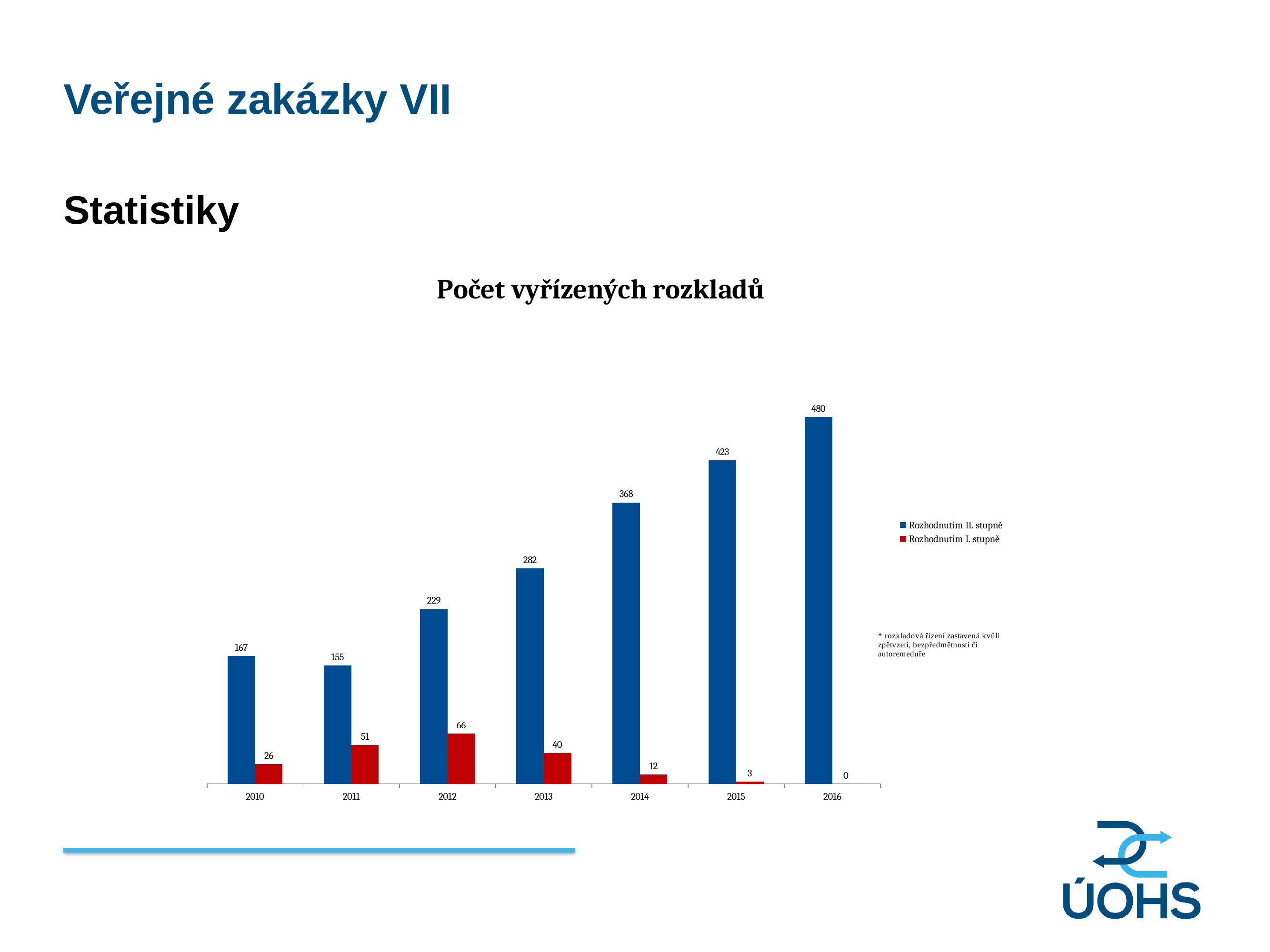
How many years are shown on the x axis? 7 What kind of chart is shown on the slide? Bar chart What is the value for Rozhodnutím II. stupně in 2013? 282 What is the value for Rozhodnutím II. stupně in 2016? 480 What is the title of the chart? Počet vyřízených rozkladů Which year has the lowest value for Rozhodnutím II. stupně? 2011 Which year has the lowest value for Rozhodnutím I. stupně? 2016 How many series does the legend list? 2 What is the difference between the Rozhodnutím II. stupně values for 2016 and 2015? 57 Which year has the highest value for Rozhodnutím II. stupně? 2016 What is the value for Rozhodnutím I. stupně in 2012? 66 Which is larger: Rozhodnutím I. stupně in 2011 or in 2013? 2011